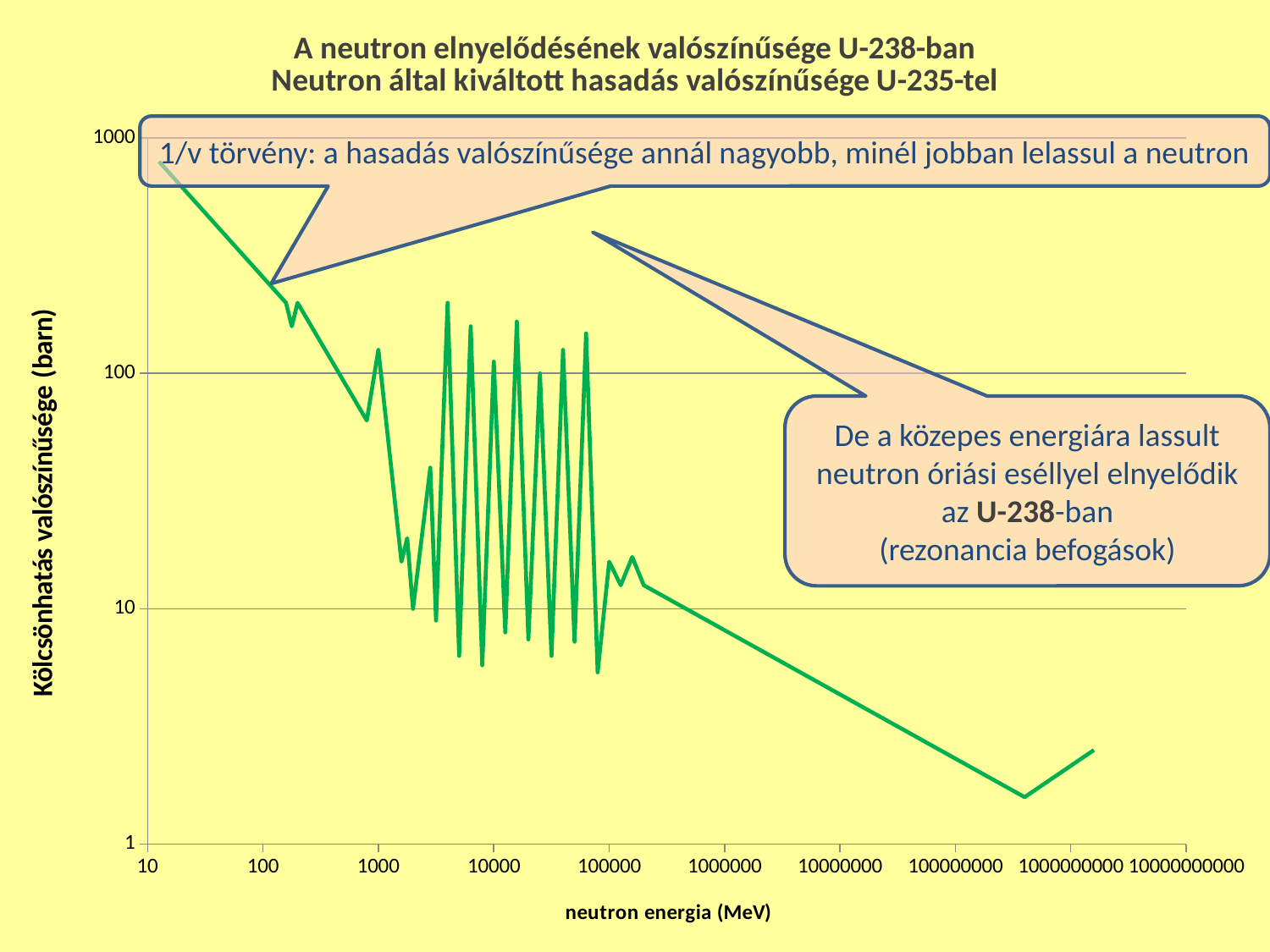
Between 10 MeV and 1000 MeV, does the line overall rise or fall as neutron energy increases? fall Is the value of the line at a neutron energy of 10 MeV greater or less than 100 barn? greater Between 100000 MeV and 1000000000 MeV, does the line rise or fall as neutron energy increases? fall Is the value of the line at a neutron energy of 100000000 MeV greater or less than 10 barn? less Is the value of the line higher at 10 MeV or at 1000000000 MeV? 10 MeV Is the value of the line at a neutron energy of 100 MeV greater or less than 100 barn? greater What is the label of the vertical axis? Kölcsönhatás valószínűsége (barn) What is the label of the horizontal axis? neutron energia (MeV) How many lines (data series) are plotted on the chart? 1 What kind of chart is shown on the slide? line chart